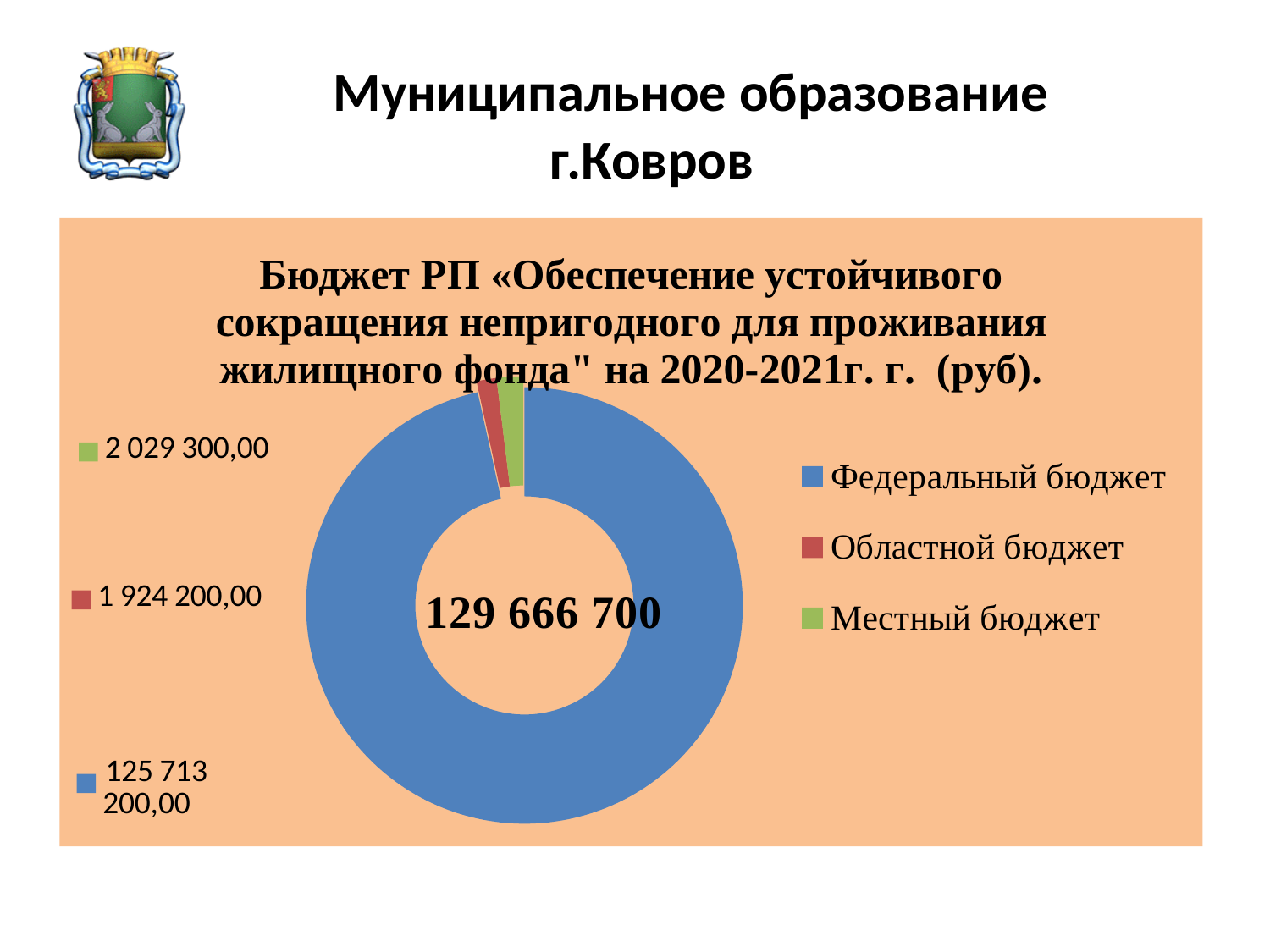
What colour represents Федеральный бюджет in the chart? Blue What is the value for Областной бюджет? 1 924 200,00 What is the value for Федеральный бюджет? 125 713 200,00 Which is larger, Областной бюджет or Местный бюджет? Местный бюджет Which budget source has the smallest value? Областной бюджет What is the difference between Федеральный бюджет and Местный бюджет? 123 683 900,00 How many budget sources are shown in the chart? 3 What is the difference between Местный бюджет and Областной бюджет? 105 100,00 Which budget source has the largest value? Федеральный бюджет What is the value for Местный бюджет? 2 029 300,00 What is the total shown in the centre of the chart? 129 666 700 What kind of chart is shown on the slide? Doughnut (pie) chart